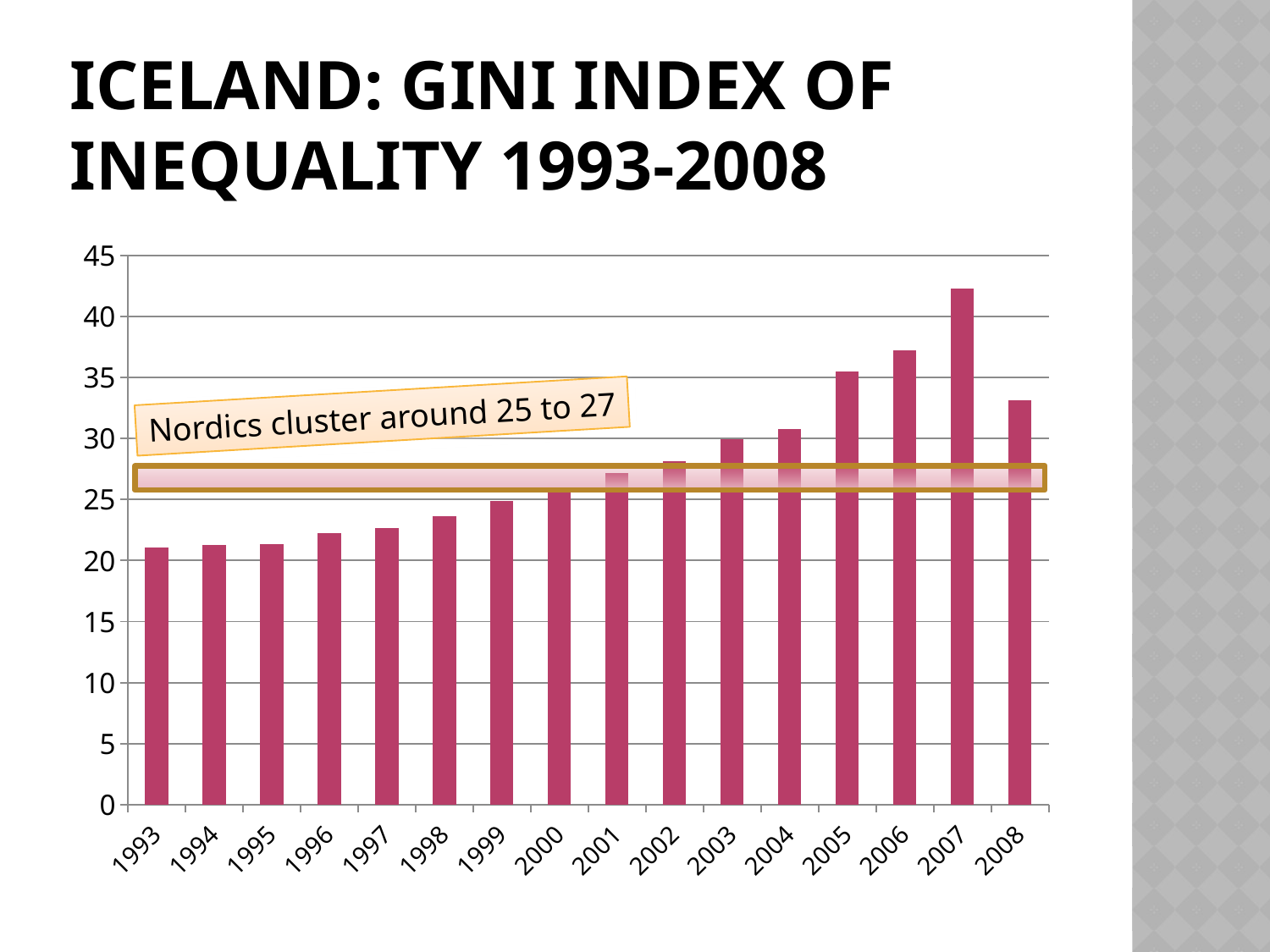
Is the value for 1998 greater or less than 25? less What does the annotation box on the chart say? Nordics cluster around 25 to 27 Which year has the highest Gini index value in the chart? 2007 Is the value for 2006 greater or less than 35? greater Which year has the larger value, 1993 or 2000? 2000 Is the value for 2007 greater or less than 40? greater Do the values generally rise or fall from 1993 to 2007? rise Which year has the larger value, 2007 or 2008? 2007 What kind of chart is shown on the slide? Bar chart How many years are plotted on the x axis of the chart? 16